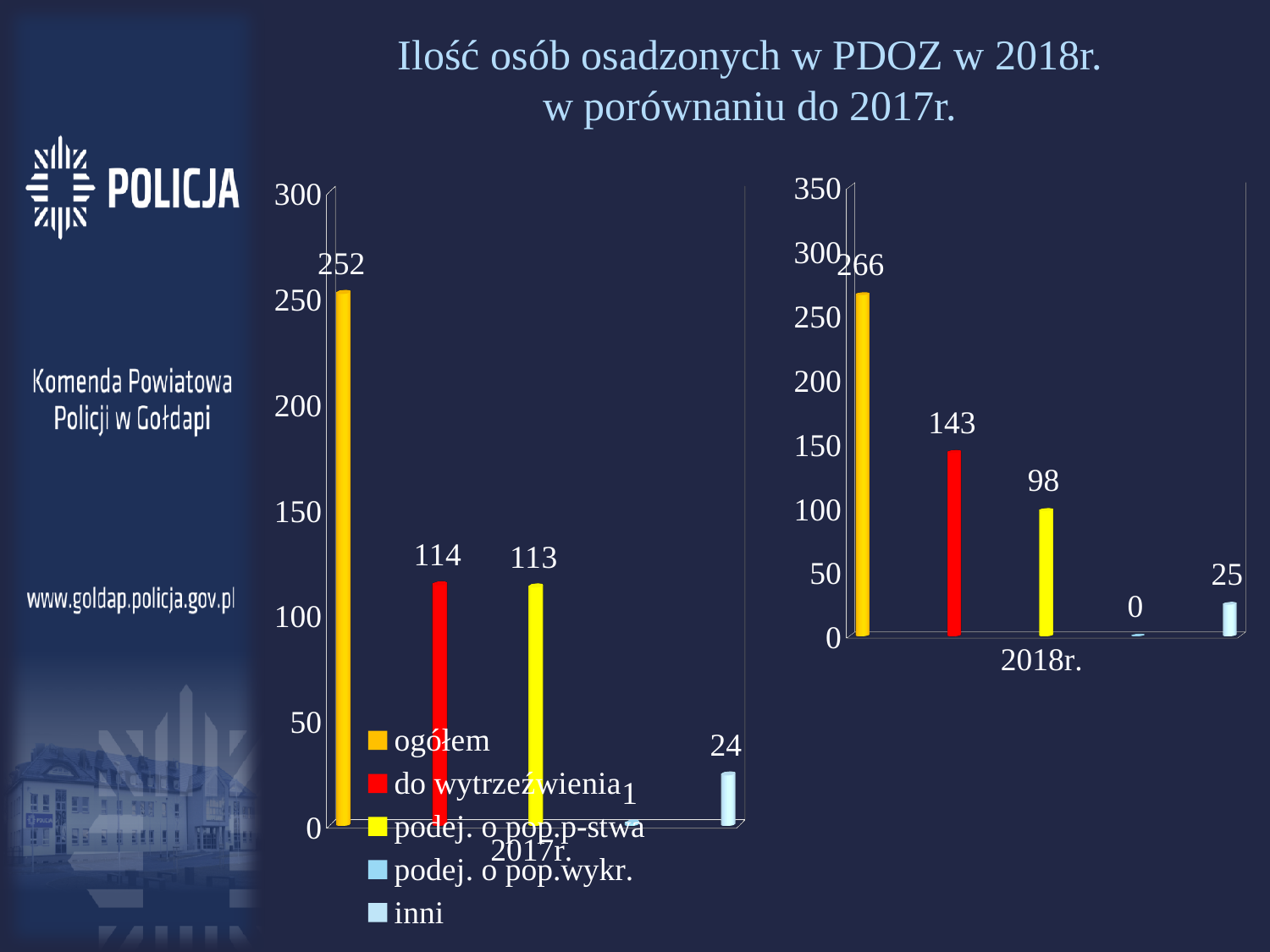
On the 2017r. chart, what is the value for inni? 24 On the 2017r. chart, which series has the lowest value? podej. o pop.wykr. On the 2018r. chart, what is the value for podej. o pop.p-stwa? 98 Which is larger: podej. o pop.p-stwa in 2017r. or podej. o pop.p-stwa in 2018r.? 2017r. On the 2017r. chart, what is the value for ogółem? 252 What is the difference between ogółem in 2018r. and ogółem in 2017r.? 14 On the 2018r. chart, which series has the highest value? ogółem What type of chart is the 2018r. chart? bar chart How many series does the legend on the 2017r. chart list? 5 On the 2017r. chart, what colour is the bar for do wytrzeźwienia? red On the 2018r. chart, what is the value for do wytrzeźwienia? 143 On the 2018r. chart, what is the difference between do wytrzeźwienia and podej. o pop.p-stwa? 45